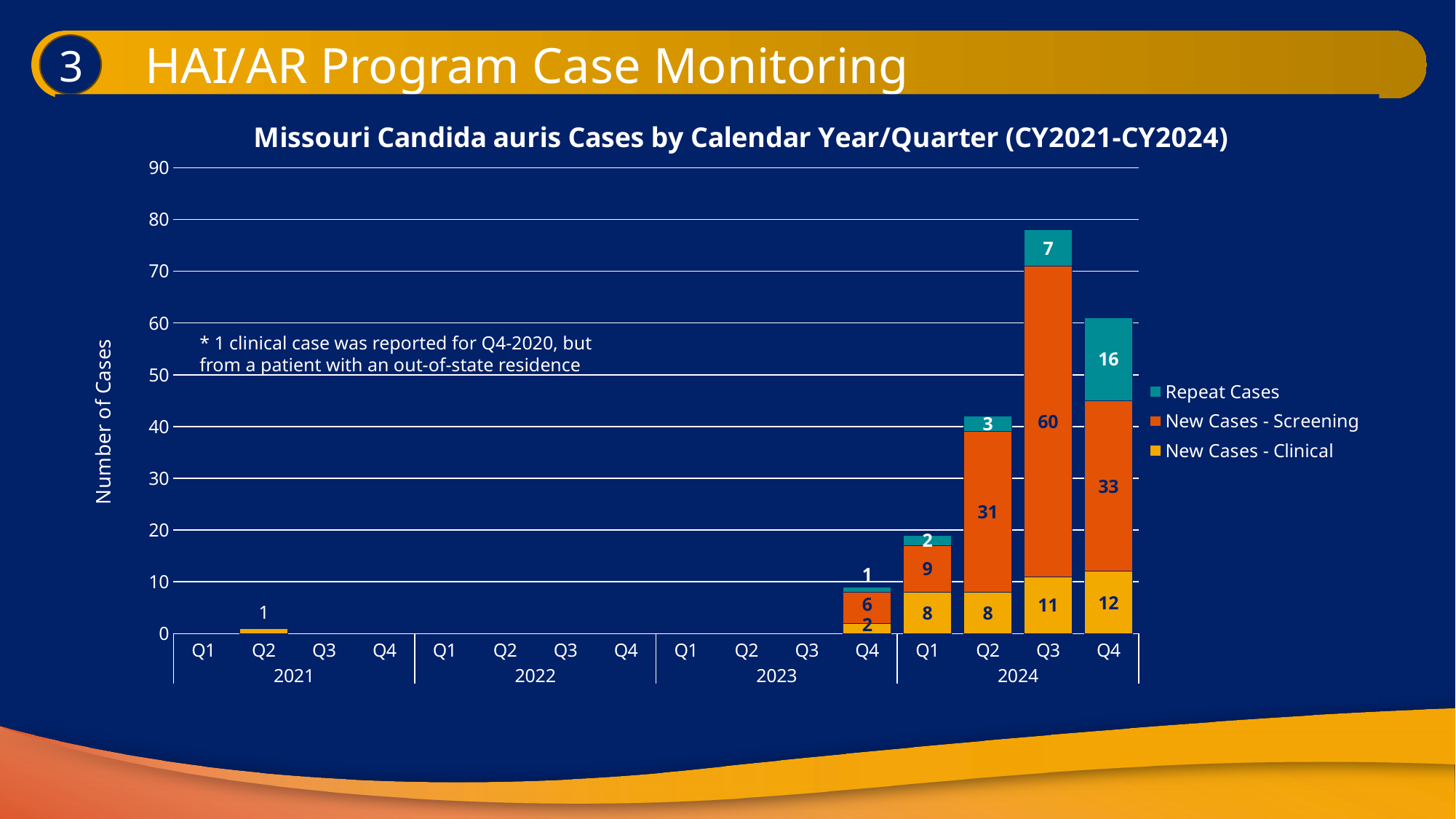
How many series does the legend list? 3 What is the difference between New Cases - Screening in Q3 2024 and Q4 2024? 27 Is the total height of the Q2 2024 stacked bar greater or less than 40? greater Which quarter has the highest value for New Cases - Screening? Q3 2024 What is the total number of cases in the stacked bar for Q4 2024? 61 What is the value of New Cases - Clinical for Q1 2024? 8 What is the value of Repeat Cases for Q4 2024? 16 What kind of chart is shown on the slide? Stacked bar chart Which is larger: Repeat Cases in Q4 2024 or Repeat Cases in Q3 2024? Q4 2024 Which series is shown in teal in the legend? Repeat Cases What is the total number of cases in the stacked bar for Q3 2024? 78 What is the value of New Cases - Screening for Q3 2024? 60